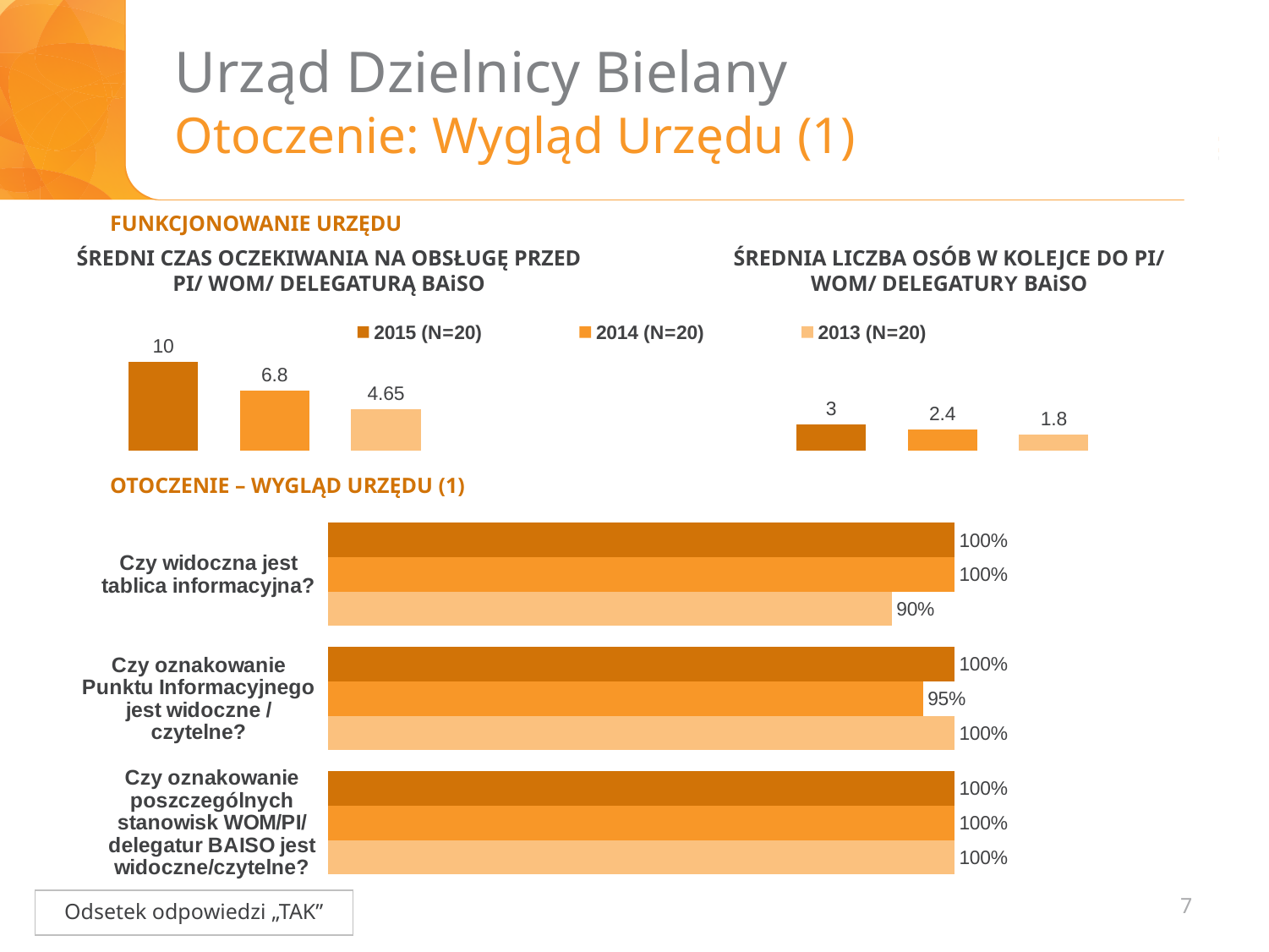
In the chart 'ŚREDNIA LICZBA OSÓB W KOLEJCE DO PI/ WOM/ DELEGATURY BAiSO', which year has the lowest value? 2013 In the chart 'OTOCZENIE – WYGLĄD URZĘDU (1)', what is the 2014 value for 'Czy oznakowanie Punktu Informacyjnego jest widoczne / czytelne?'? 95% In the chart 'ŚREDNI CZAS OCZEKIWANIA NA OBSŁUGĘ PRZED PI/ WOM/ DELEGATURĄ BAiSO', which year has the highest value? 2015 What type of chart is 'OTOCZENIE – WYGLĄD URZĘDU (1)'? Bar chart In the chart 'ŚREDNI CZAS OCZEKIWANIA NA OBSŁUGĘ PRZED PI/ WOM/ DELEGATURĄ BAiSO', what is the value for 2015? 10 In the chart 'ŚREDNI CZAS OCZEKIWANIA NA OBSŁUGĘ PRZED PI/ WOM/ DELEGATURĄ BAiSO', what is the difference between the 2015 and 2014 values? 3.2 How many series does the legend list for the charts in the 'FUNKCJONOWANIE URZĘDU' section? 3 In the chart 'ŚREDNIA LICZBA OSÓB W KOLEJCE DO PI/ WOM/ DELEGATURY BAiSO', what is the difference between the 2015 and 2013 values? 1.2 In the chart 'ŚREDNI CZAS OCZEKIWANIA NA OBSŁUGĘ PRZED PI/ WOM/ DELEGATURĄ BAiSO', what is the value for 2013? 4.65 In the chart 'OTOCZENIE – WYGLĄD URZĘDU (1)', what is the 2013 value for 'Czy widoczna jest tablica informacyjna?'? 90% In the chart 'ŚREDNIA LICZBA OSÓB W KOLEJCE DO PI/ WOM/ DELEGATURY BAiSO', what is the value for 2014? 2.4 In the chart 'OTOCZENIE – WYGLĄD URZĘDU (1)', how many question categories are shown? 3